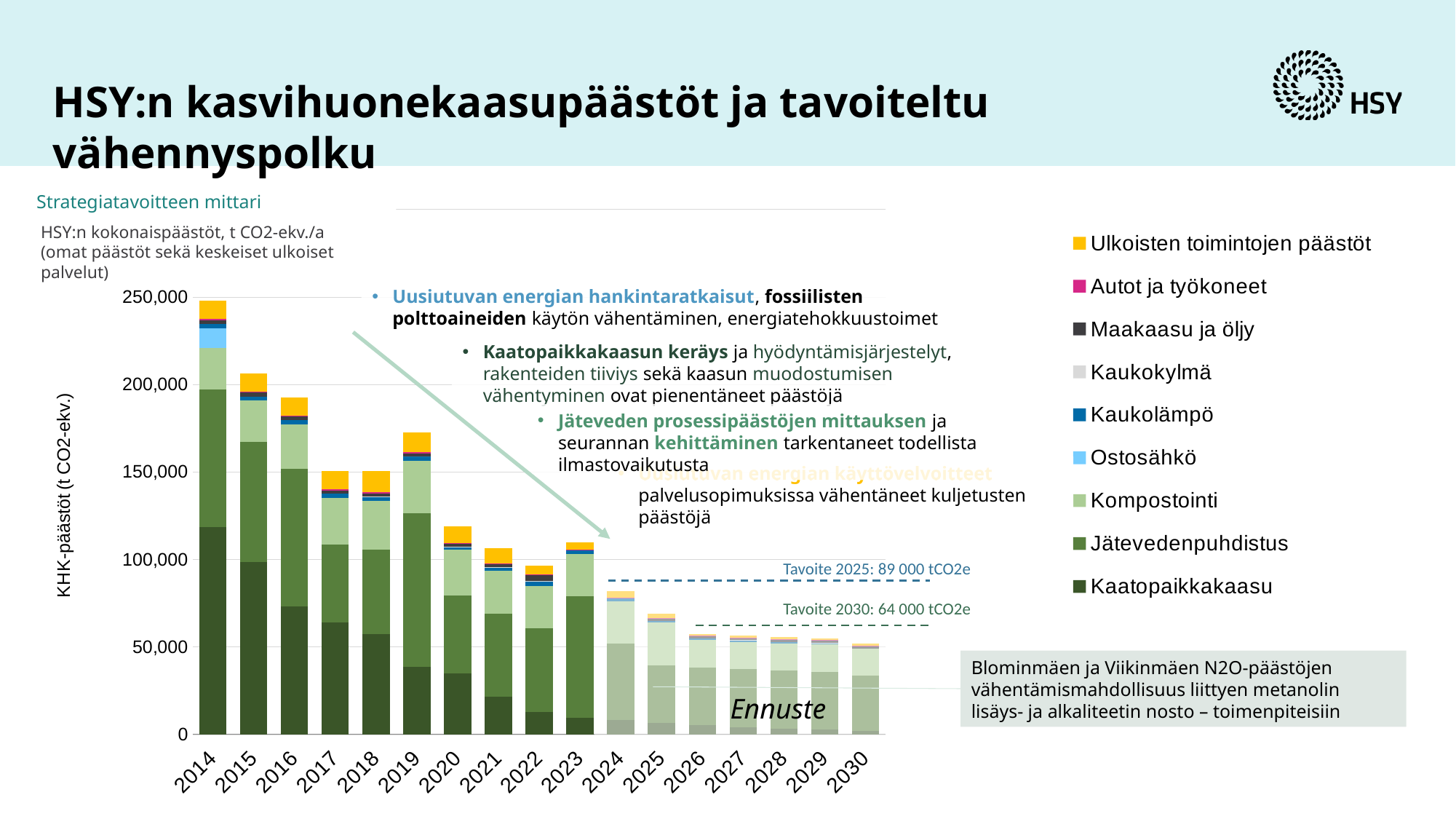
What kind of chart is shown on the slide? Stacked bar chart What is the 2025 target (Tavoite 2025) shown on the chart? 89 000 tCO2e Is the total value for 2020 greater or less than 100,000? greater Is the total value for 2014 greater or less than 200,000? greater Do the total emissions generally rise or fall from 2014 to 2030? Fall Is the total value for 2024 greater or less than 100,000? less What is the label of the y axis of the chart? KHK-päästöt (t CO2-ekv.) How many years are shown on the x axis of the chart? 17 How many series does the chart legend list? 9 Which year has the highest total emissions in the chart? 2014 Which year has the larger total emissions, 2015 or 2018? 2015